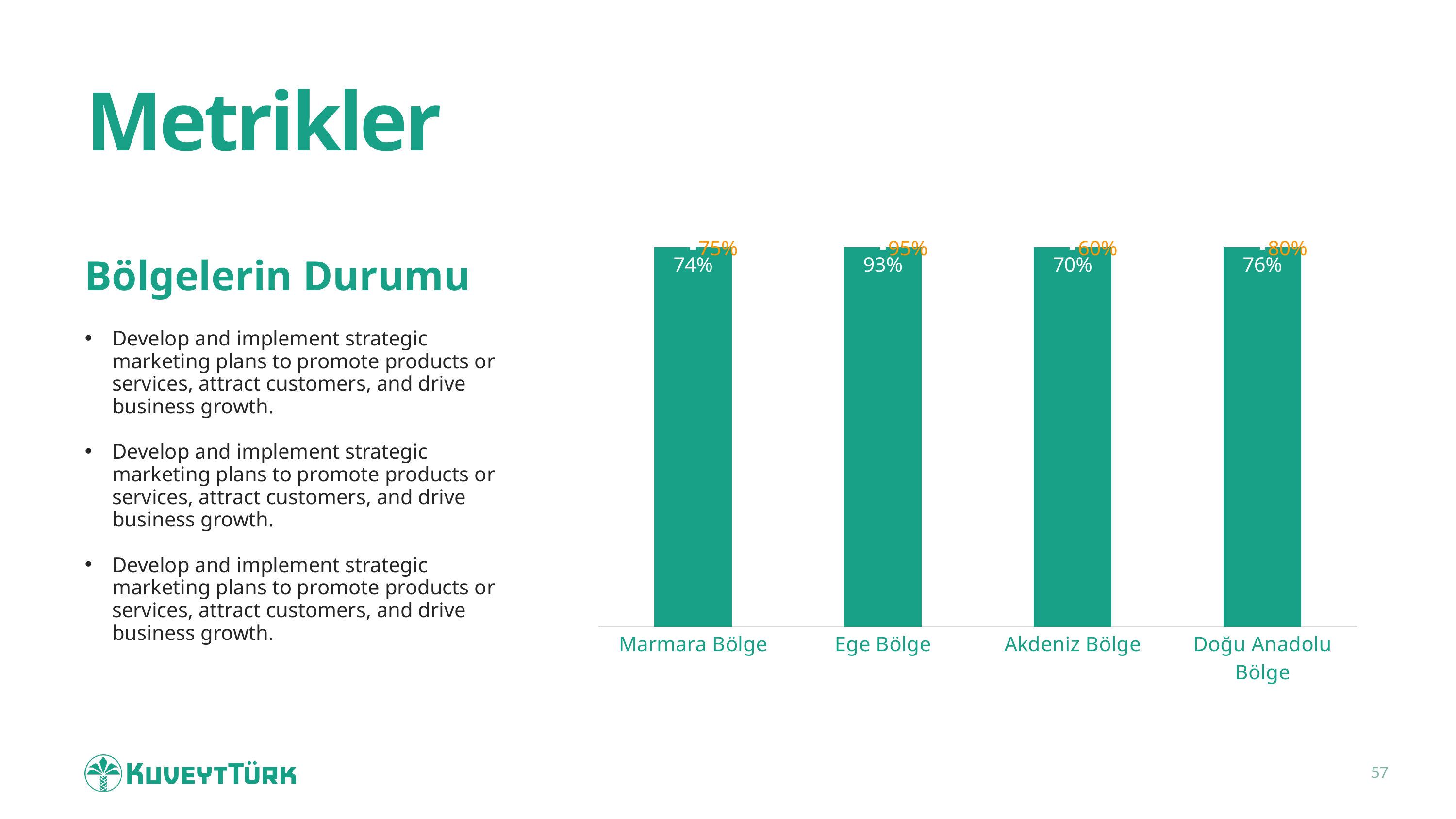
For Akdeniz Bölge, which is larger: the white label value or the orange label value? The white label value (70%) How many regions are shown on the x axis of the chart? 4 What value is printed in white inside the bar for Akdeniz Bölge? 70% Which region has the highest white data label value? Ege Bölge What value is printed in white inside the bar for Marmara Bölge? 74% What type of chart is shown on the slide? Bar chart What is the difference between the white label values for Ege Bölge and Marmara Bölge? 19 percentage points What orange value is printed above the bar for Ege Bölge? 95% What value is printed in white inside the bar for Doğu Anadolu Bölge? 76% Which region has the lowest white data label value? Akdeniz Bölge What value is printed in white inside the bar for Ege Bölge? 93% What orange value is printed above the bar for Akdeniz Bölge? 60%